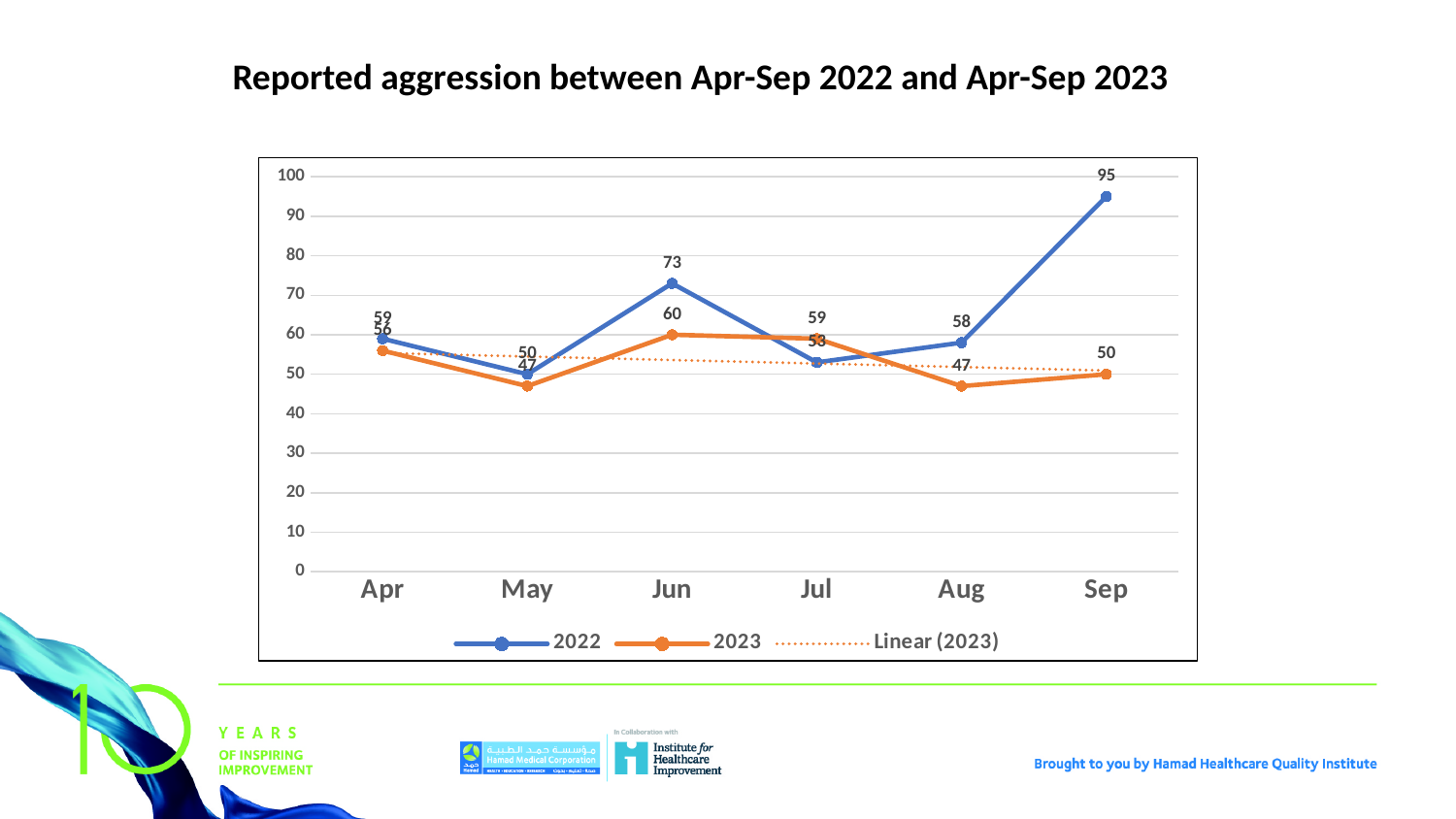
What is the value for 2023 in Jun? 60 How many entries does the legend list? 3 How many months are shown on the x axis? 6 What is the difference between the 2022 and 2023 values in Sep? 45 What is the title of the chart? Reported aggression between Apr-Sep 2022 and Apr-Sep 2023 Which series has the larger value in Jul, 2022 or 2023? 2023 What is the value for 2022 in Jun? 73 Is the 2022 value in Sep greater or less than 90? greater In which month is the 2022 value highest? Sep What type of chart is shown on the slide? line chart What is the value for 2022 in Sep? 95 In which month is the 2022 value lowest? May